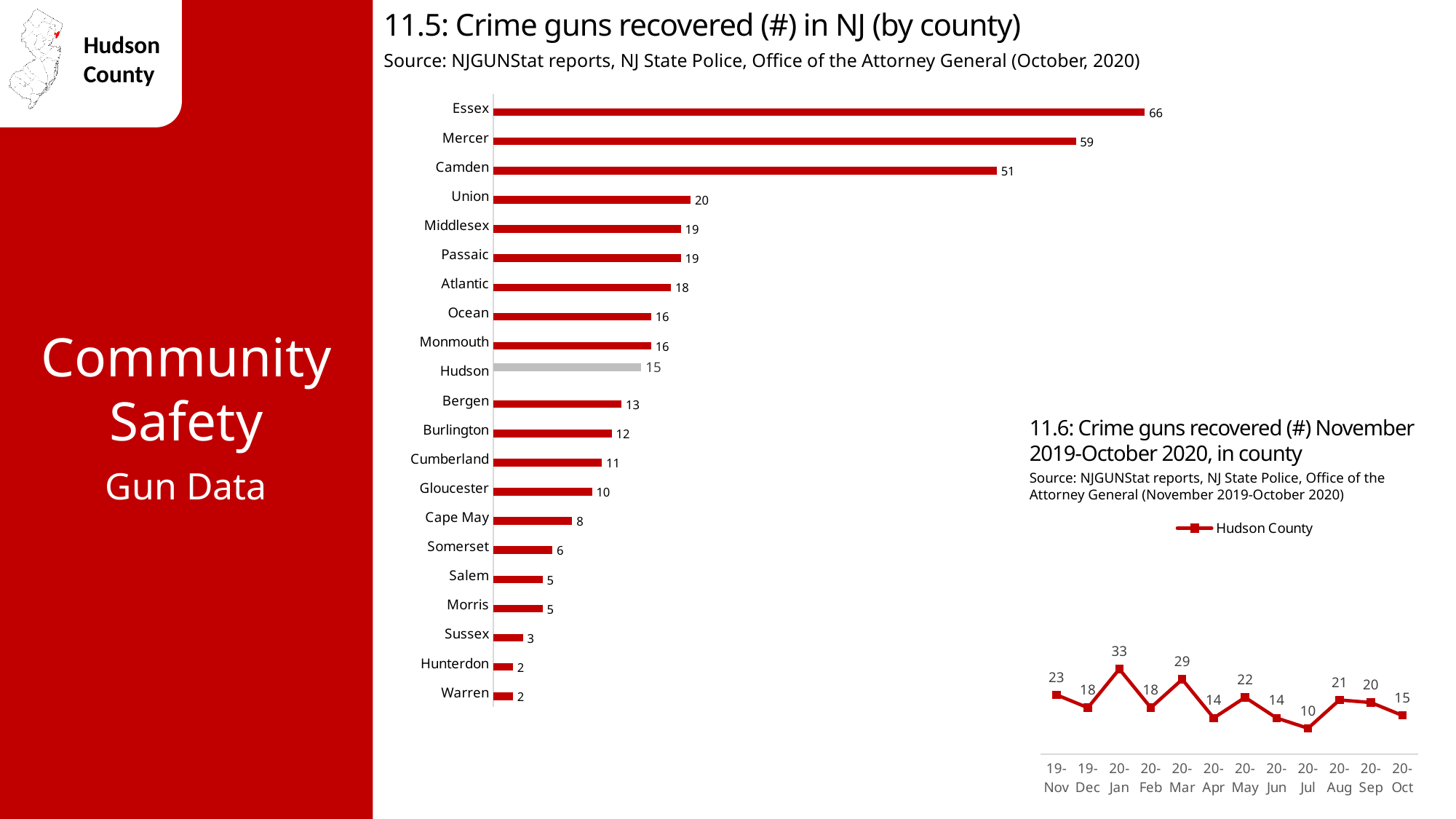
In the chart '11.5: Crime guns recovered (#) in NJ (by county)', what kind of chart is shown? Bar chart In the chart '11.6: Crime guns recovered (#) November 2019-October 2020, in county', what series does the legend list? Hudson County In the chart '11.5: Crime guns recovered (#) in NJ (by county)', what is the value for Cape May? 8 In the chart '11.5: Crime guns recovered (#) in NJ (by county)', what is the difference between Essex and Mercer? 7 In the chart '11.5: Crime guns recovered (#) in NJ (by county)', which county has the highest number of crime guns recovered? Essex In the chart '11.5: Crime guns recovered (#) in NJ (by county)', how many crime guns were recovered in Hudson? 15 In the chart '11.6: Crime guns recovered (#) November 2019-October 2020, in county', how many data points are plotted? 12 In the chart '11.6: Crime guns recovered (#) November 2019-October 2020, in county', which month has the lowest value? 20-Jul In the chart '11.6: Crime guns recovered (#) November 2019-October 2020, in county', what is the difference between 20-Mar and 20-Apr? 15 In the chart '11.5: Crime guns recovered (#) in NJ (by county)', how many counties are listed? 21 In the chart '11.5: Crime guns recovered (#) in NJ (by county)', which is larger, Union or Camden? Camden In the chart '11.6: Crime guns recovered (#) November 2019-October 2020, in county', what is the value for 20-Jan? 33